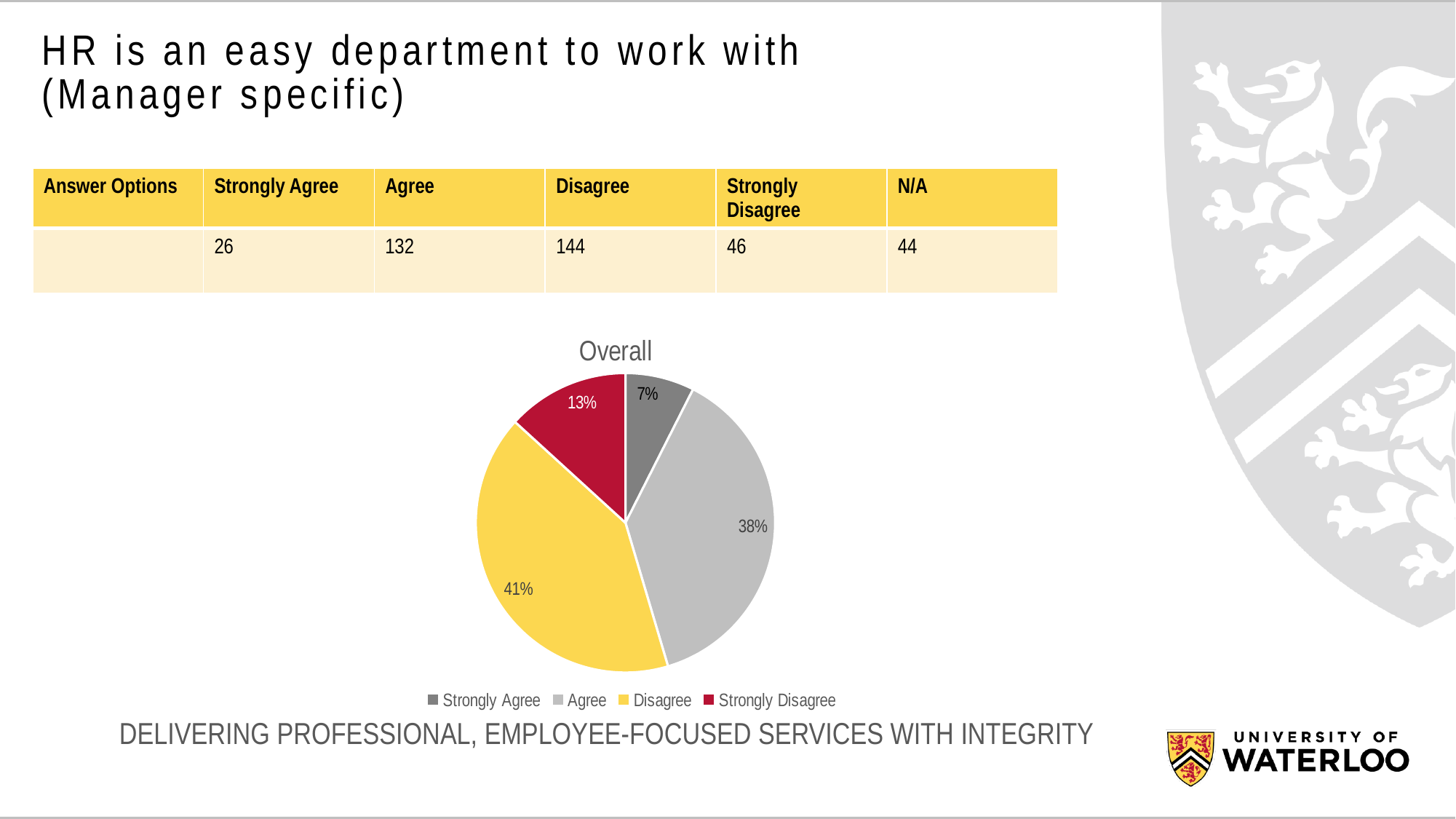
Which category has the largest slice of the pie? Disagree Which category has the smallest slice of the pie? Strongly Agree How many slices does the pie chart have? 4 What is the title of the chart? Overall What share of the pie does the Strongly Agree slice represent? 7% How many entries does the legend list? 4 What is the difference in percentage points between the Disagree and Strongly Agree slices? 34 What type of chart is shown on the slide? pie chart What share of the pie does the Strongly Disagree slice represent? 13% What share of the pie does the Disagree slice represent? 41% Which slice is larger, Agree or Strongly Disagree? Agree